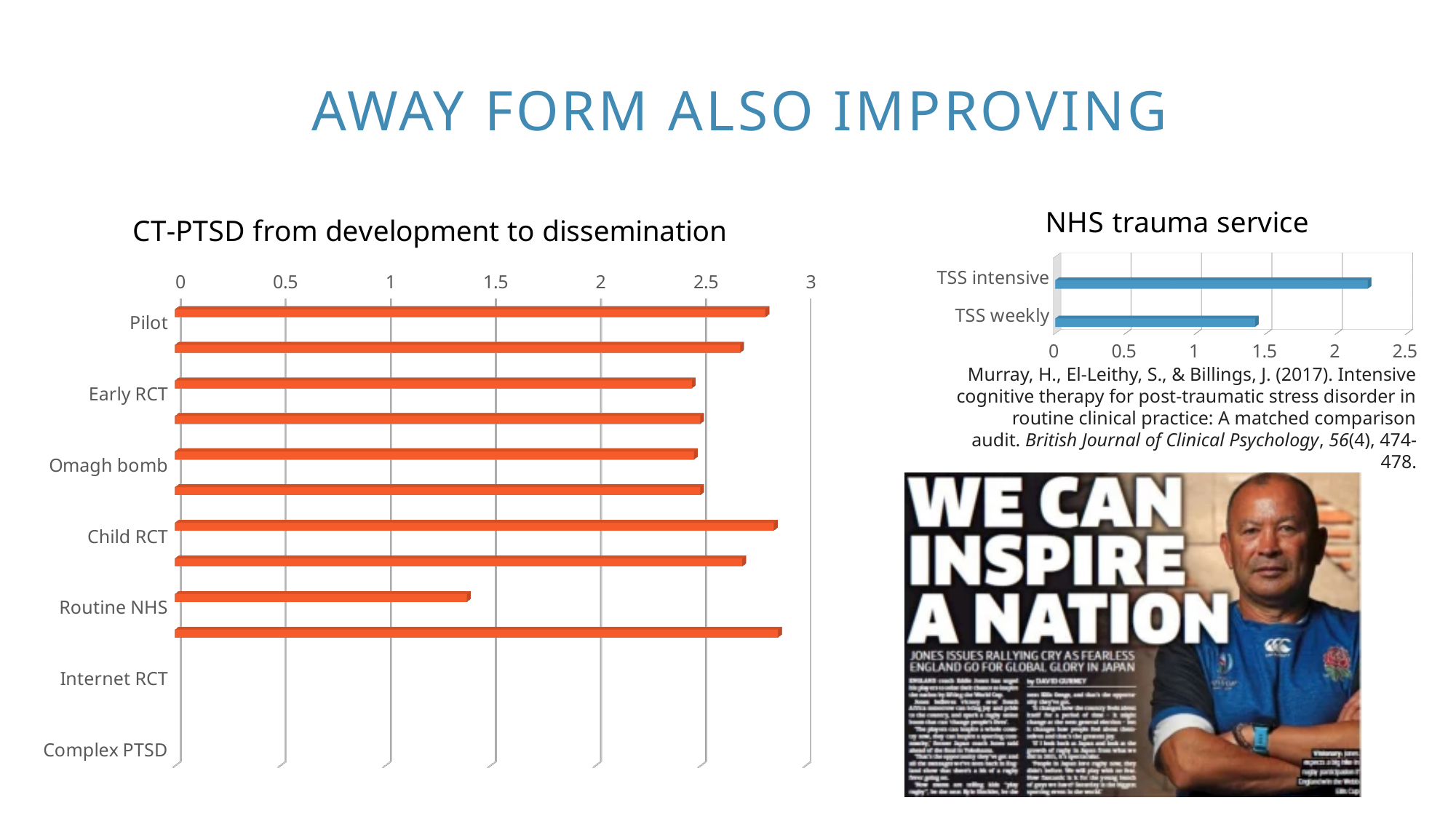
In the 'NHS trauma service' chart, is the value for TSS weekly greater or less than 1? greater What kind of chart is the 'NHS trauma service' chart? bar chart In the 'CT-PTSD from development to dissemination' chart, is the value for Pilot greater or less than 2.5? greater In the 'CT-PTSD from development to dissemination' chart, is the value for Routine NHS greater or less than 1.5? less In the 'NHS trauma service' chart, which category has the highest value? TSS intensive In the 'CT-PTSD from development to dissemination' chart, which is larger, the value for Pilot or the value for Routine NHS? Pilot In the 'CT-PTSD from development to dissemination' chart, which labelled category has the lowest value? Routine NHS What kind of chart is the 'CT-PTSD from development to dissemination' chart? bar chart What is the highest value shown on the x axis of the 'CT-PTSD from development to dissemination' chart? 3 How many categories does the 'NHS trauma service' chart show? 2